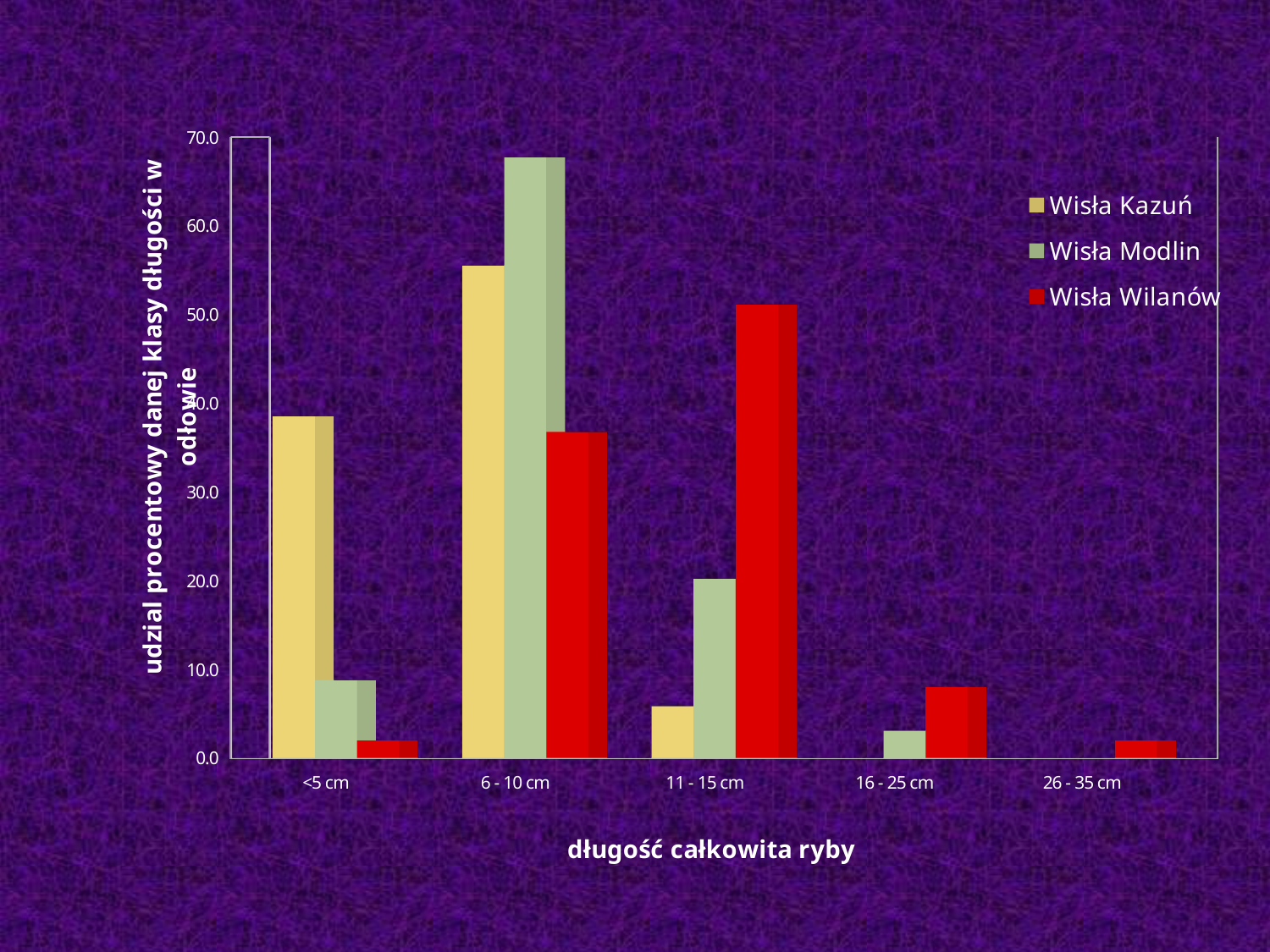
Which length category has the highest value for Wisła Modlin? 6 - 10 cm In the 11 - 15 cm category, which series has the larger value: Wisła Modlin or Wisła Wilanów? Wisła Wilanów In the <5 cm category, which series has the larger value: Wisła Kazuń or Wisła Modlin? Wisła Kazuń What is the title of the x axis? długość całkowita ryby What kind of chart is shown on the slide? bar chart How many series does the legend list? 3 Is the value for Wisła Modlin in the 6 - 10 cm category greater or less than 60.0? greater Which length category has the highest value for Wisła Kazuń? 6 - 10 cm Is the value for Wisła Wilanów in the 11 - 15 cm category greater or less than 50.0? greater Which length category has the highest value for Wisła Wilanów? 11 - 15 cm Is the value for Wisła Kazuń in the <5 cm category greater or less than 40.0? less How many length categories are shown on the x axis? 5